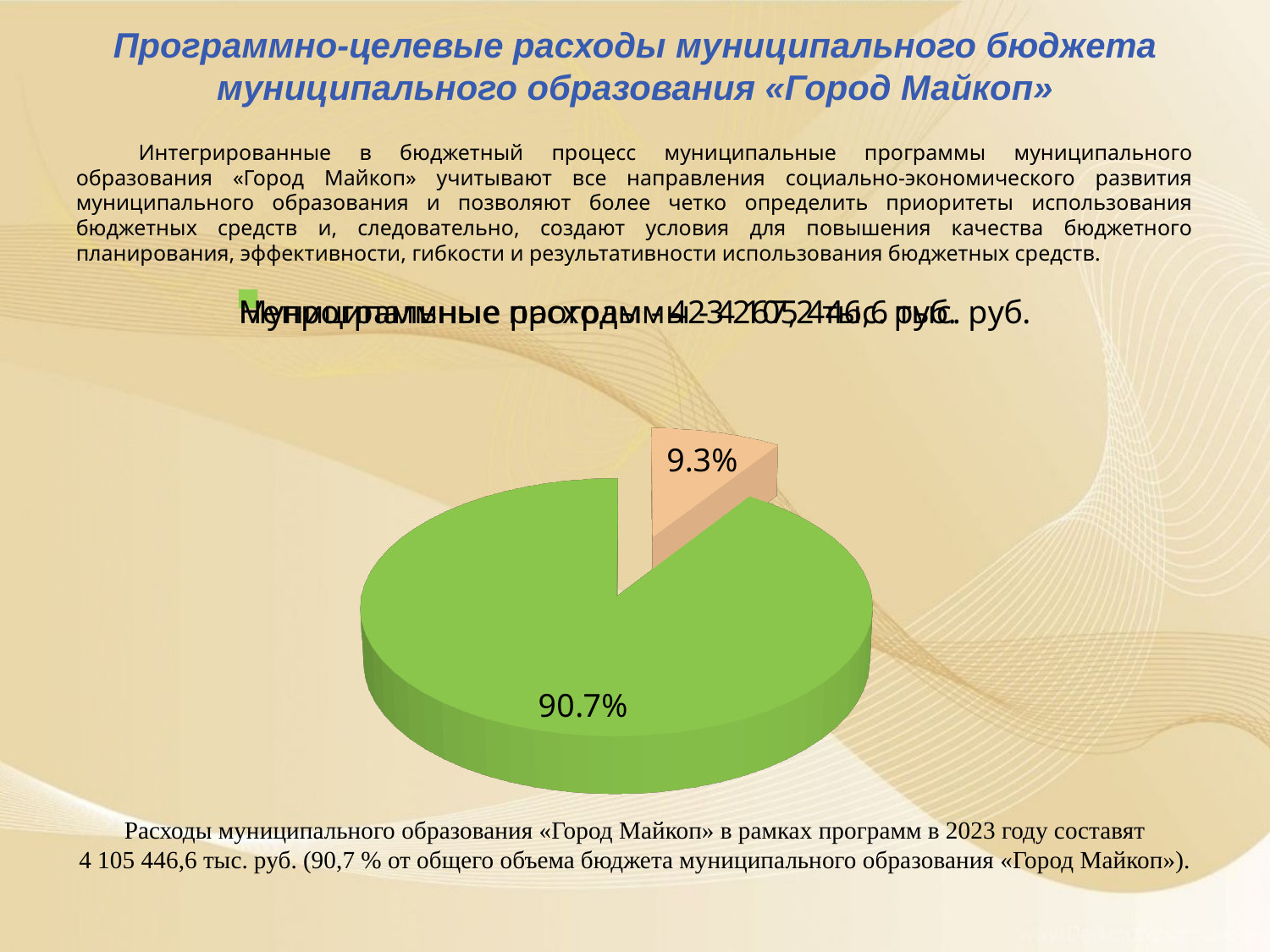
What percentage is shown on the small peach-coloured slice of the pie chart? 9.3% What percentage is shown on the green slice of the pie chart? 90.7% What colour is the slice representing 90.7%? green Which slice is larger, the green one or the peach-coloured one? the green one Is the share of the peach-coloured slice greater or less than 10%? less How many slices does the pie chart have? 2 What is the smallest share shown in the pie chart? 9.3% What kind of chart is shown on the slide? pie chart Is the share of the green slice greater or less than 50%? greater Is the pie chart drawn in 3D or flat 2D? 3D What is the largest share shown in the pie chart? 90.7% By how many percentage points does the green slice exceed the peach-coloured slice? 81.4